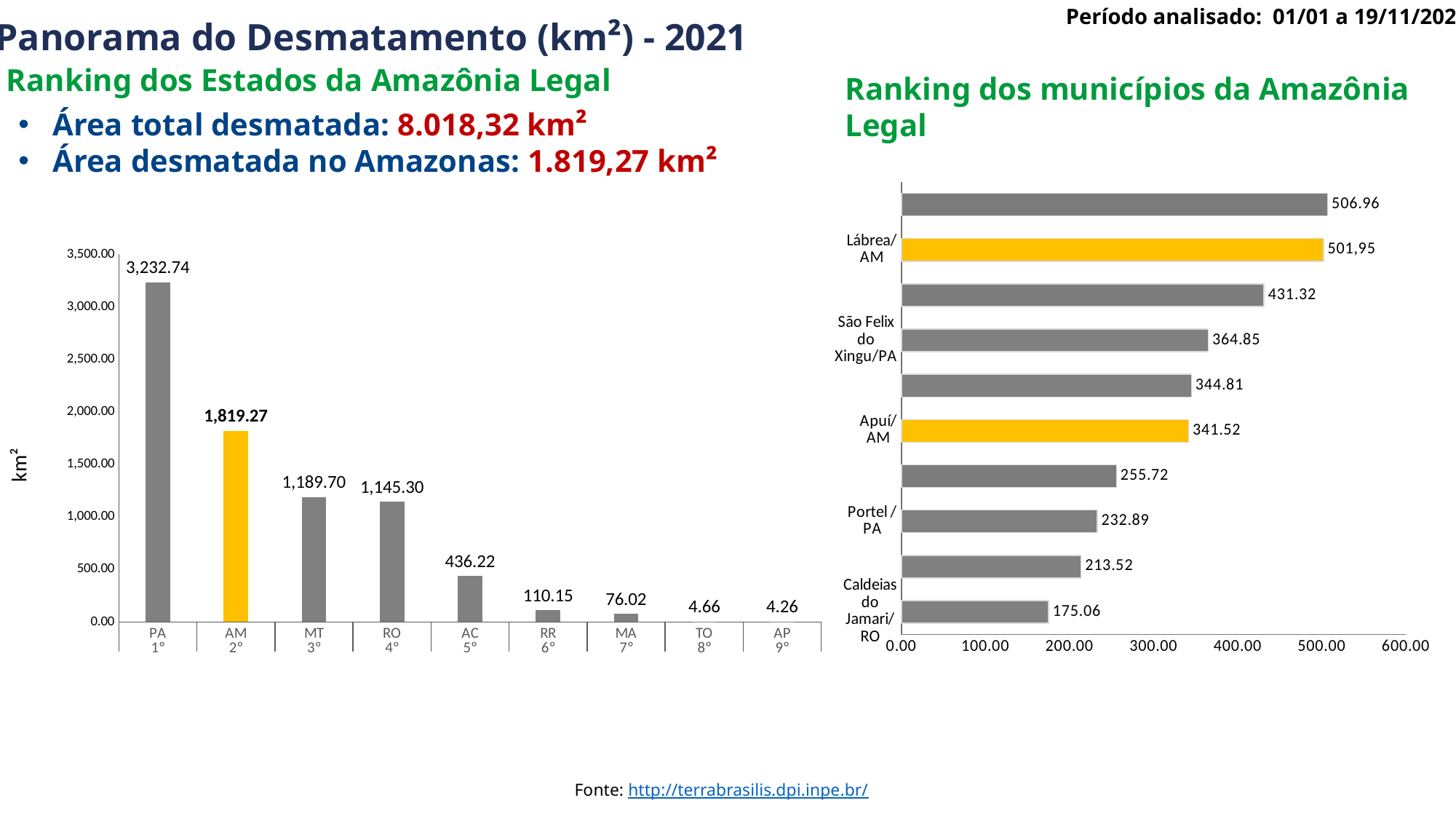
In the 'Ranking dos Estados da Amazônia Legal' chart, what is the value for PA? 3,232.74 In the 'Ranking dos Estados da Amazônia Legal' chart, what is the difference between the values for MT and RO? 44.40 What kind of chart is the 'Ranking dos municípios da Amazônia Legal' chart? bar chart In the 'Ranking dos municípios da Amazônia Legal' chart, what is the value for Apuí/AM? 341.52 In the 'Ranking dos municípios da Amazônia Legal' chart, which is larger, the value for São Felix do Xingu/PA or Portel / PA? São Felix do Xingu/PA In the 'Ranking dos Estados da Amazônia Legal' chart, which state has the highest value? PA In the 'Ranking dos Estados da Amazônia Legal' chart, which state has the lowest value? AP In the 'Ranking dos Estados da Amazônia Legal' chart, how many states are shown? 9 In the 'Ranking dos Estados da Amazônia Legal' chart, what is the value for AM? 1,819.27 In the 'Ranking dos Estados da Amazônia Legal' chart, do the values rise or fall from left to right? fall In the 'Ranking dos municípios da Amazônia Legal' chart, what is the value for Lábrea/AM? 501,95 In the 'Ranking dos Estados da Amazônia Legal' chart, which bar is coloured yellow? AM